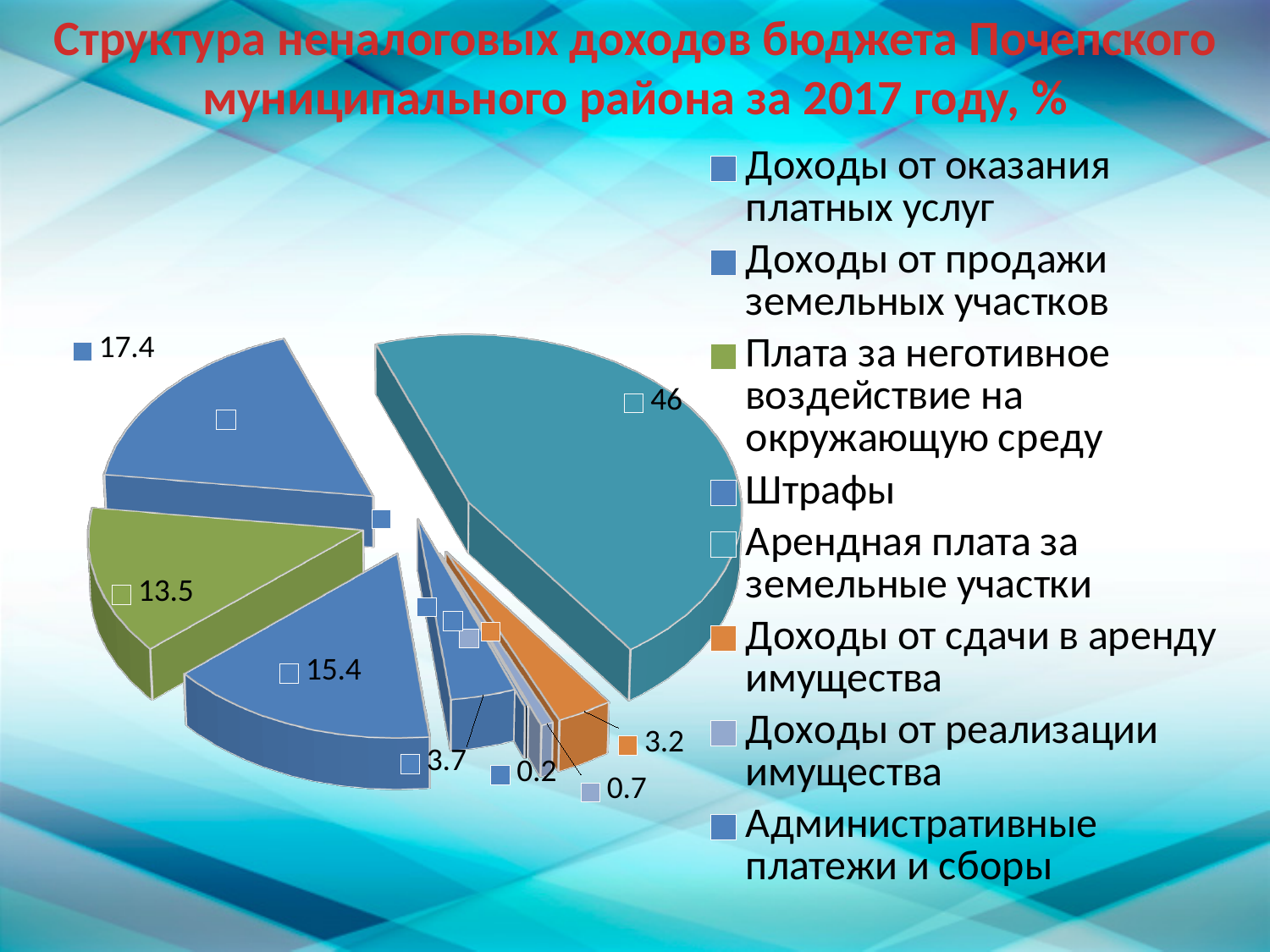
What is the value for 'Доходы от реализации имущества'? 0.7 What is the difference between the largest slice (46) and the slice labelled 17.4? 28.6 What is the value of the largest slice of the pie chart? 46 How many entries does the legend list? 8 What is the value for 'Арендная плата за земельные участки' (the teal slice)? 46 What is the value for 'Доходы от сдачи в аренду имущества' (the orange slice)? 3.2 What is the value for 'Плата за негативное воздействие на окружающую среду' (the green slice)? 13.5 What is the title of the chart on the slide? Структура неналоговых доходов бюджета Почепского муниципального района за 2017 году, % What is the value of the smallest slice of the pie chart? 0.2 How many slices does the pie chart have? 8 What kind of chart is shown on the slide? pie chart Which is larger: the slice labelled 15.4 or the slice labelled 13.5? 15.4